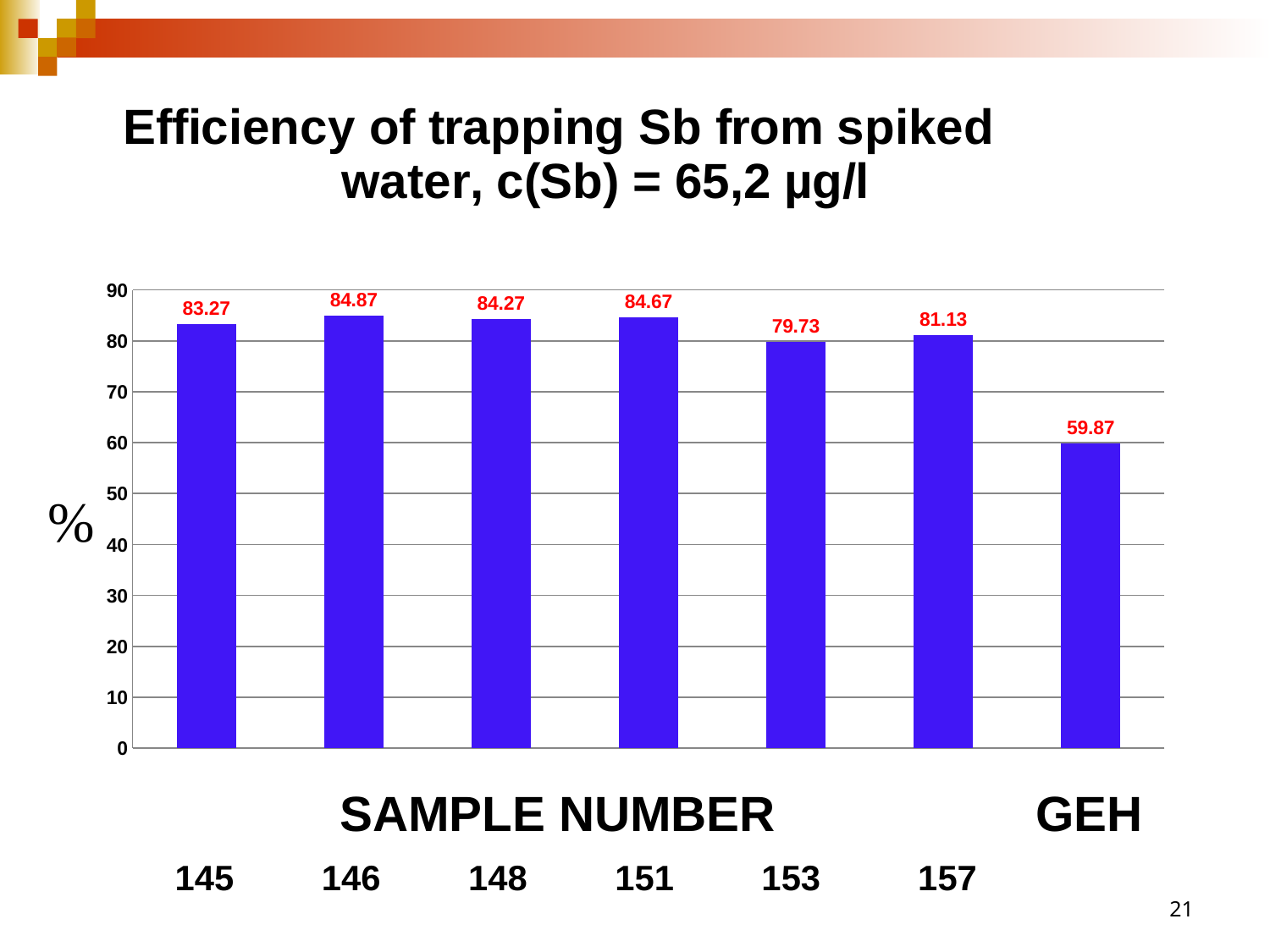
What is the value shown for GEH? 59.87 What is the difference between the values for sample 146 and GEH? 25 Which is larger, the value for sample 151 or the value for sample 157? 151 What kind of chart is shown on the slide? bar chart What is the difference between the values for sample 157 and sample 153? 1.4 Which bar has the lowest value? GEH How many bars are shown in the chart? 7 What is the label on the vertical axis? % What is the trapping efficiency for sample 145? 83.27 What is the trapping efficiency for sample 153? 79.73 Which sample has the highest trapping efficiency? 146 Is the value for sample 153 greater or less than 80? less